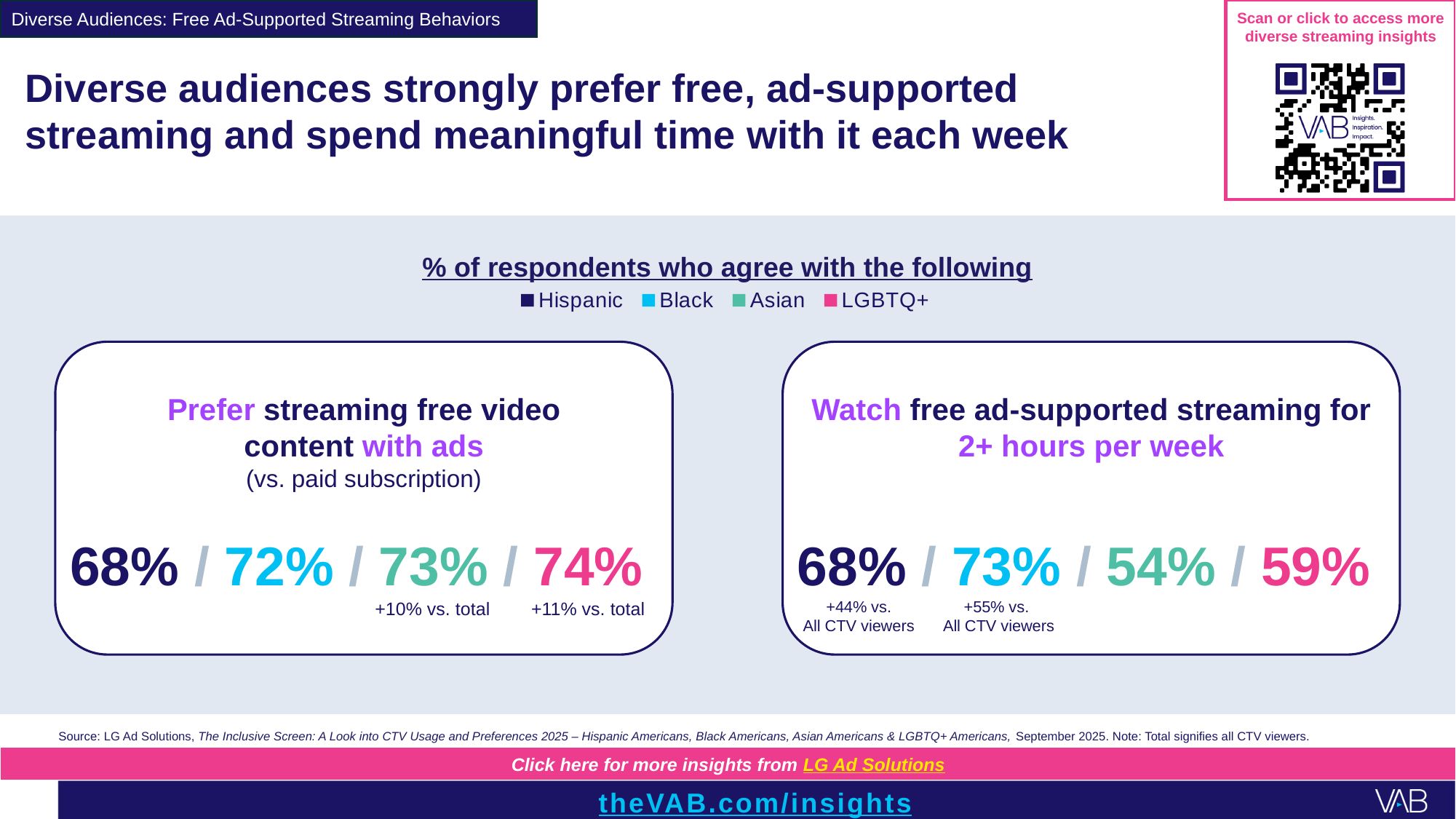
In the 'Watch free ad-supported streaming for 2+ hours per week' box, what percentage of Asian respondents agree? 54% In the 'Watch free ad-supported streaming for 2+ hours per week' box, what percentage of Black respondents agree? 73% In the 'Prefer streaming free video content with ads' box, which audience group has the highest percentage? LGBTQ+ In the 'Watch free ad-supported streaming for 2+ hours per week' box, which audience group has the lowest percentage? Asian In the 'Prefer streaming free video content with ads' box, what is the difference between the LGBTQ+ and Hispanic percentages? 6% How many audience groups does the legend list? 4 In the 'Watch free ad-supported streaming for 2+ hours per week' box, which is larger, the Hispanic value or the LGBTQ+ value? Hispanic In the 'Watch free ad-supported streaming for 2+ hours per week' box, what is the difference between the Black and Asian percentages? 19% In the 'Prefer streaming free video content with ads' box, what percentage of LGBTQ+ respondents agree? 74% What is the title above the legend describing what the percentages represent? % of respondents who agree with the following In the 'Watch free ad-supported streaming for 2+ hours per week' box, which audience group has the highest percentage? Black In the 'Prefer streaming free video content with ads' box, what percentage of Hispanic respondents agree? 68%